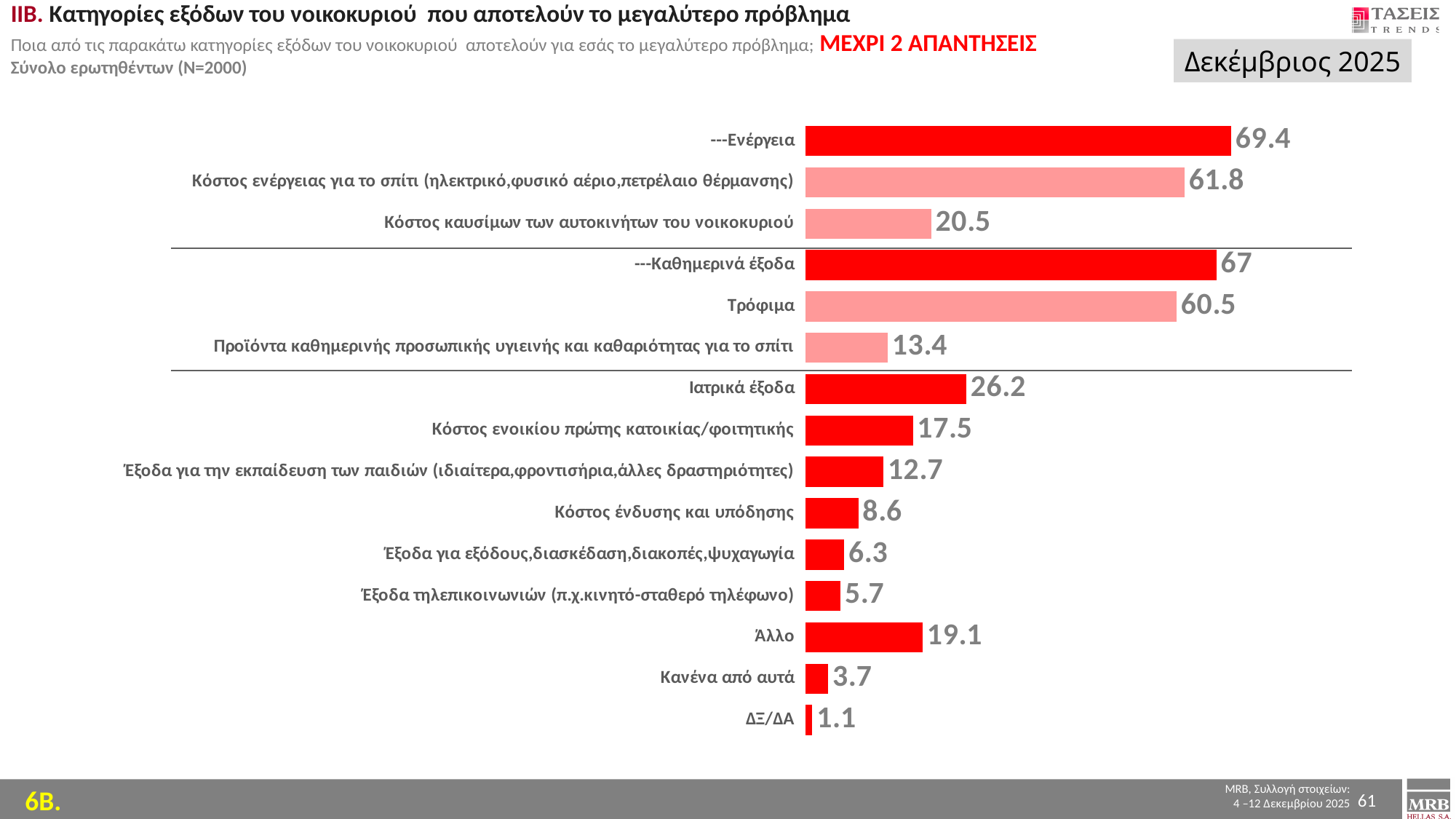
Which is larger, the value for Κόστος ένδυσης και υπόδησης or the value for Έξοδα τηλεπικοινωνιών? Κόστος ένδυσης και υπόδησης Which category has the highest value? ---Ενέργεια What is the value for Κόστος ενοικίου πρώτης κατοικίας/φοιτητικής? 17.5 What is the value for Ιατρικά έξοδα? 26.2 Which category has the lowest value? ΔΞ/ΔΑ What is the value for Τρόφιμα? 60.5 What is the difference between the values for Άλλο and Κανένα από αυτά? 15.4 What is the value for Ενέργεια? 69.4 How many categories (bars) are shown in the chart? 15 Which is larger, the value for Κόστος καυσίμων των αυτοκινήτων του νοικοκυριού or the value for Ιατρικά έξοδα? Ιατρικά έξοδα What is the difference between the values for Ενέργεια and Καθημερινά έξοδα? 2.4 What kind of chart is shown on the slide? Bar chart